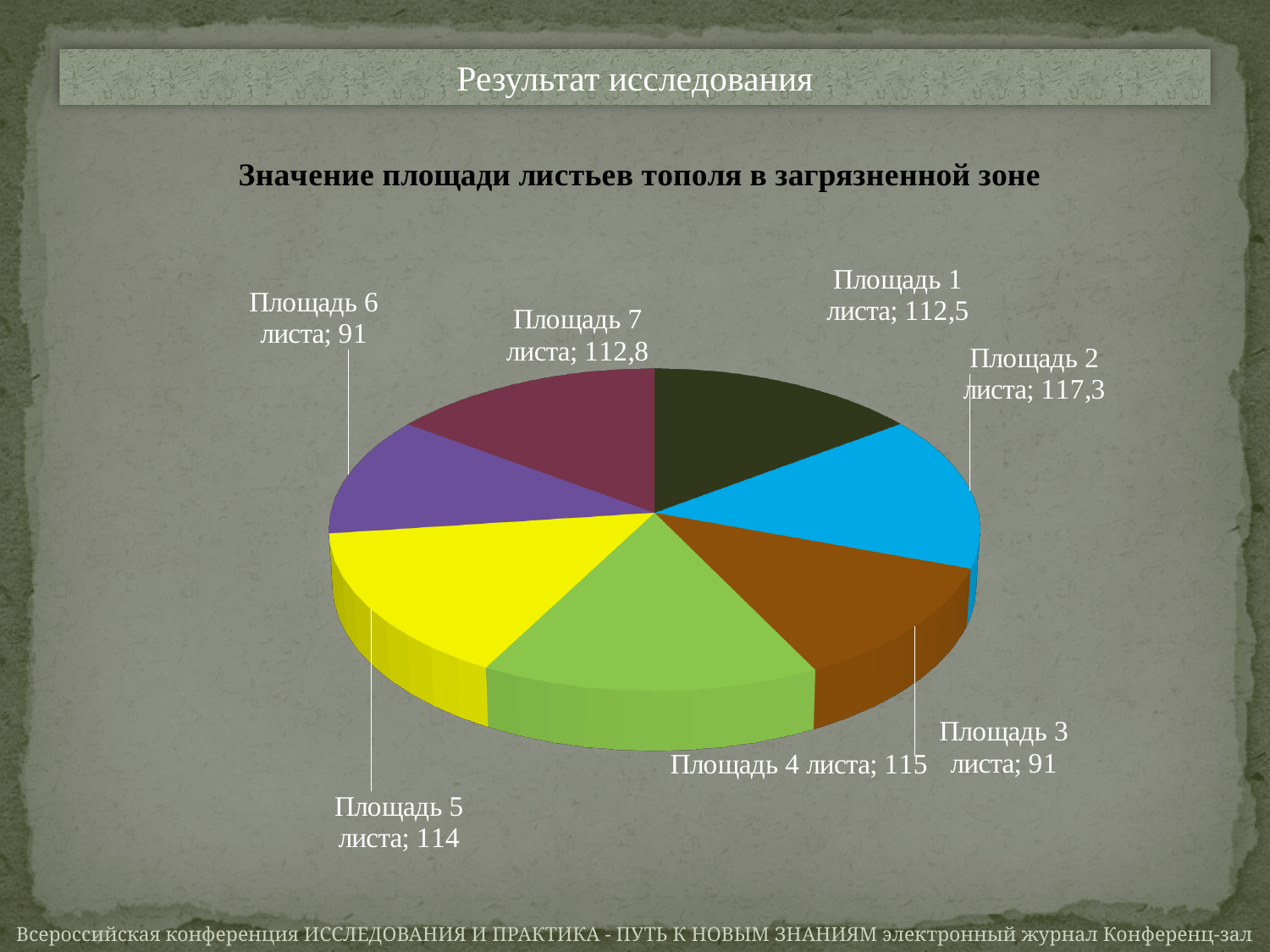
How many slices does the pie chart have? 7 Which slice has the highest value? Площадь 2 листа What is the value for Площадь 7 листа? 112,8 What is the total of all slice values in the pie chart? 753,6 What is the value for Площадь 2 листа? 117,3 What kind of chart is shown on the slide? Pie chart What is the difference between the values for Площадь 2 листа and Площадь 1 листа? 4,8 What is the value for Площадь 5 листа? 114 Which two slices share the lowest value? Площадь 3 листа and Площадь 6 листа What is the difference between the values for Площадь 4 листа and Площадь 3 листа? 24 What is the title of the chart? Значение площади листьев тополя в загрязненной зоне Which is larger, the value for Площадь 1 листа or Площадь 6 листа? Площадь 1 листа